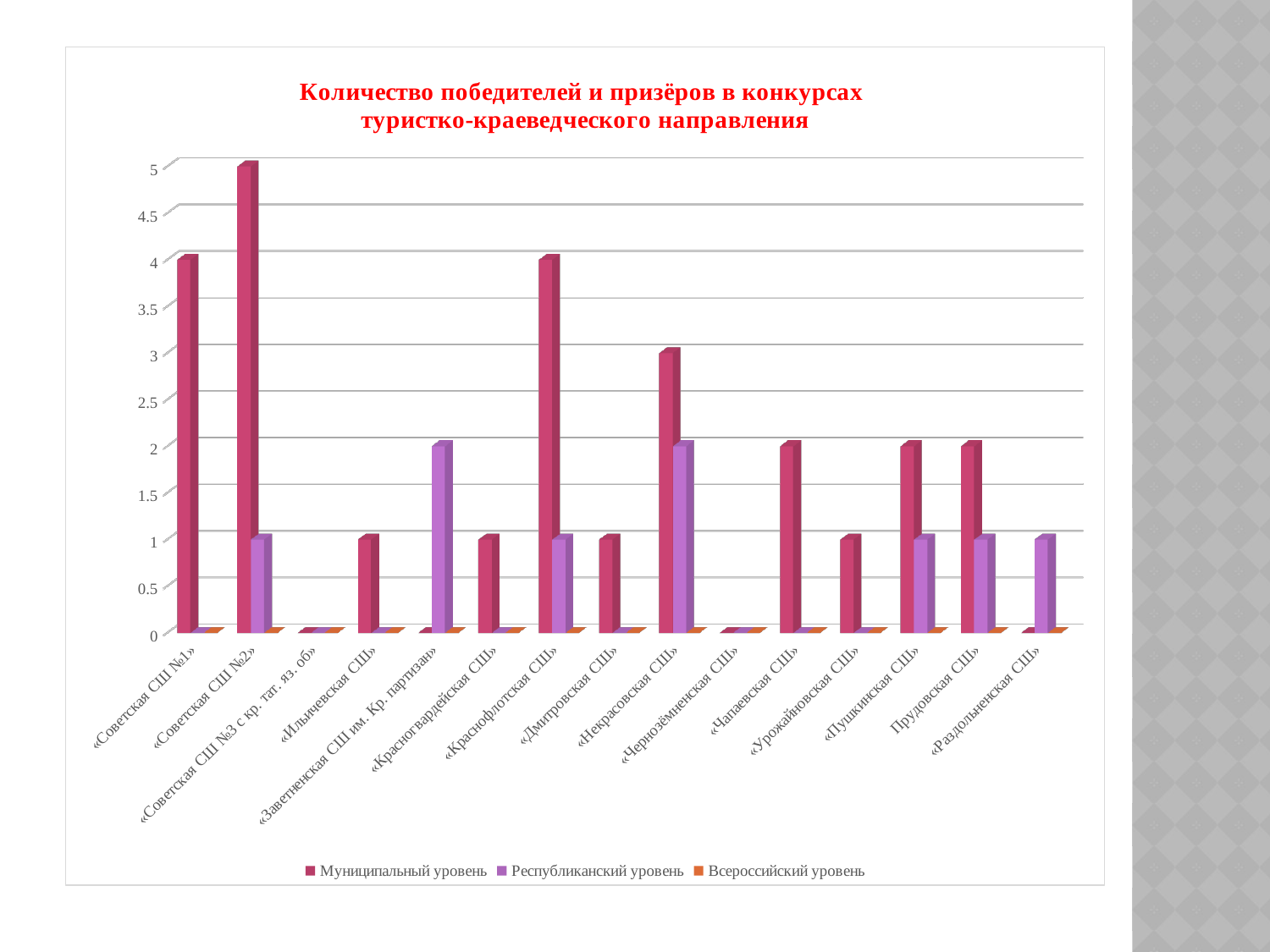
Which school has the highest value for Муниципальный уровень? «Советская СШ №2» Which series is shown in orange in the legend? Всероссийский уровень What is the value of Муниципальный уровень for «Некрасовская СШ»? 3 Which has the larger Муниципальный уровень value: «Краснофлотская СШ» or «Некрасовская СШ»? «Краснофлотская СШ» How many schools (categories) are shown on the x axis? 15 How many series does the legend list? 3 Is the Муниципальный уровень value for «Советская СШ №2» greater or less than 4.5? greater What is the difference between the Муниципальный уровень values for «Советская СШ №2» and «Советская СШ №1»? 1 What is the value of Муниципальный уровень for «Советская СШ №2»? 5 What kind of chart is shown on the slide? Bar chart What is the value of Республиканский уровень for «Пушкинская СШ»? 1 What is the value of Республиканский уровень for «Заветненская СШ им. Кр. партизан»? 2